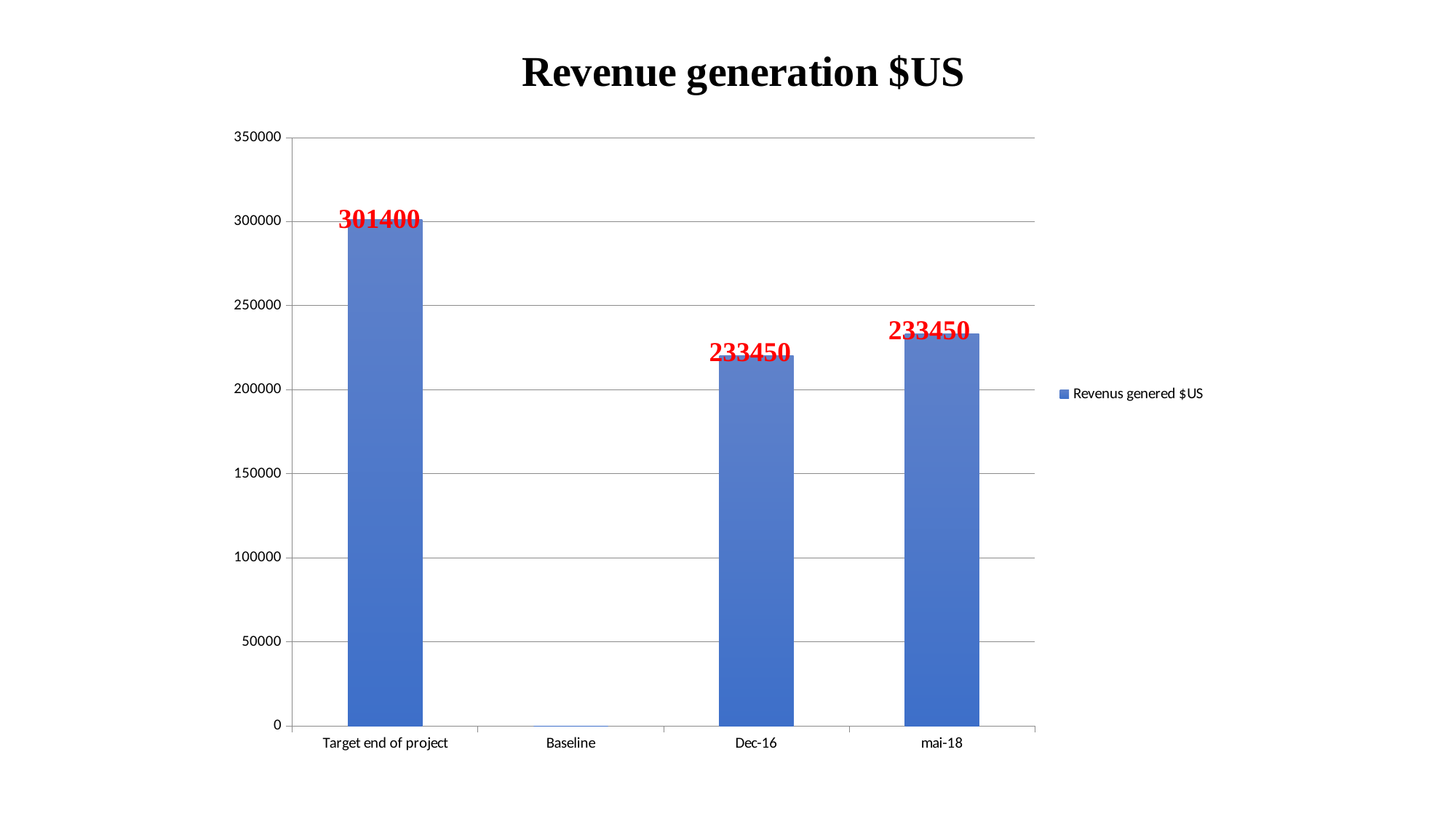
Which is larger, the value for Target end of project or the value for mai-18? Target end of project What is the value for Target end of project? 301400 Is the value for Dec-16 greater or less than 250000? less What type of chart is shown on the slide? bar chart What is the series name shown in the legend? Revenus genered $US What is the difference between the value for Target end of project and the value for mai-18? 67950 What is the value for mai-18? 233450 Which category has the highest value? Target end of project How many categories are shown on the x axis? 4 Is the value for Target end of project greater or less than 250000? greater What is the title of the chart? Revenue generation $US How many series does the legend list? 1